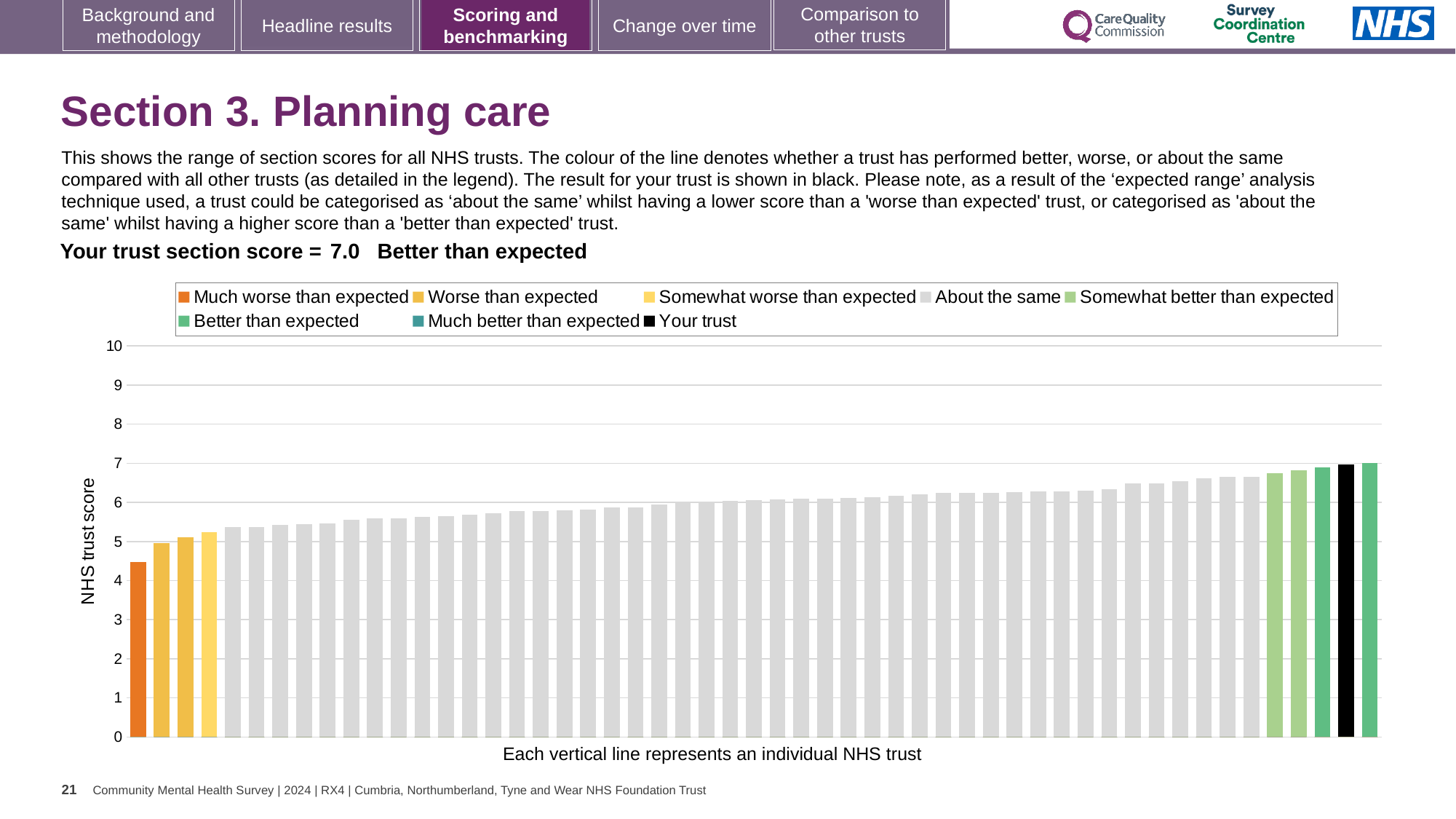
What kind of chart is shown on the slide? Bar chart How many bars are coloured orange ('Much worse than expected')? 1 How many entries does the chart legend list? 8 What is your trust's section score for Planning care? 7.0 Is the value for the black 'Your trust' bar greater or less than 6? greater Is the value for the orange 'Much worse than expected' bar greater or less than 5? less Is the value for the lowest bar on the chart greater or less than 4? greater Which is larger, the leftmost bar or the rightmost bar? The rightmost bar How is your trust's Planning care section score categorised? Better than expected What is the label on the vertical axis of the chart? NHS trust score Do the NHS trust scores rise or fall from left to right across the chart? Rise